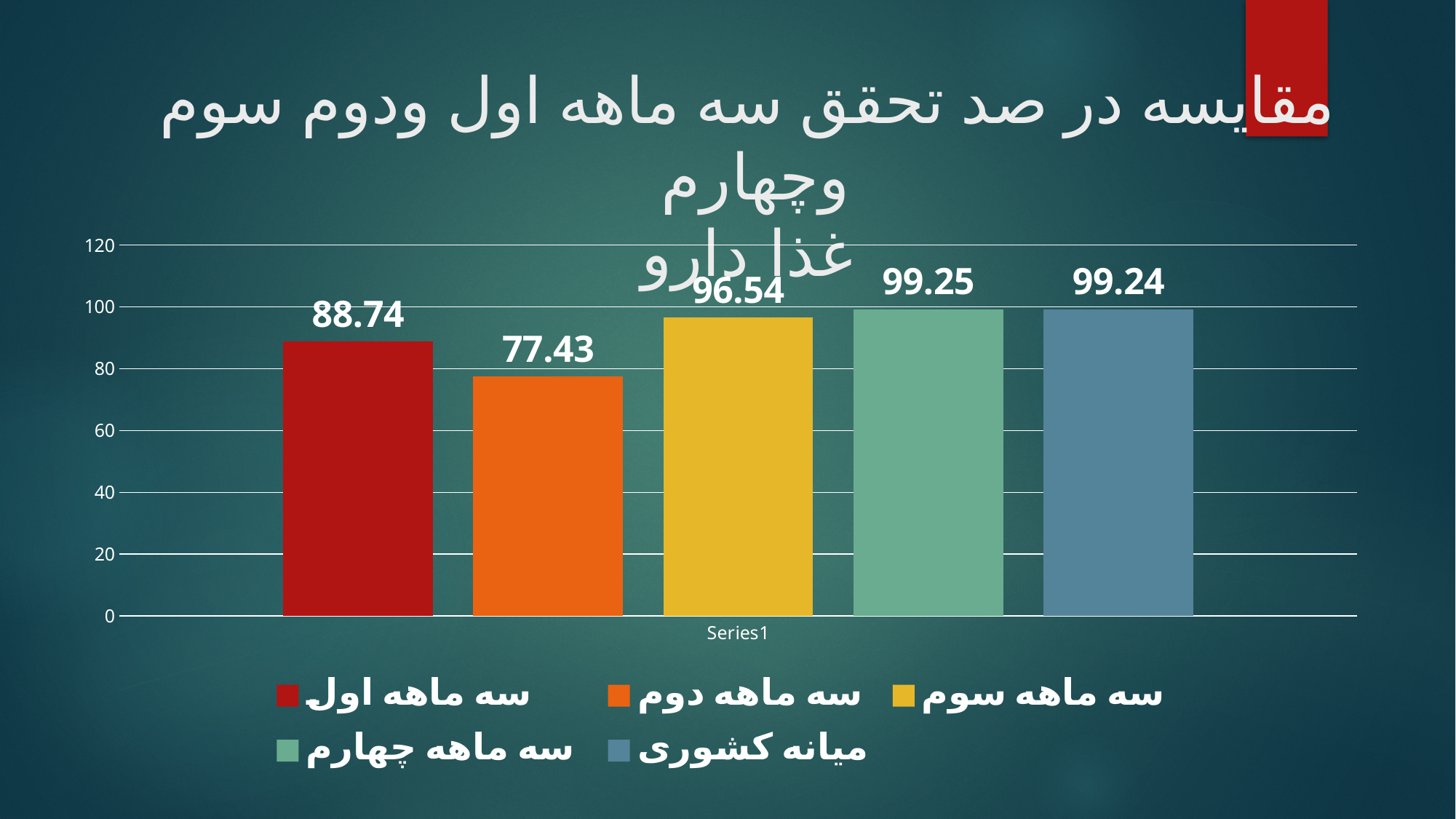
How many series does the legend list? 5 What kind of chart is shown on the slide? bar chart Which series has the lowest value? سه ماهه دوم What is the value for سه ماهه سوم? 96.54 Is the value for سه ماهه دوم greater or less than 80? less Which is larger, the value for سه ماهه سوم or the value for سه ماهه اول? سه ماهه سوم What is the difference between the values for سه ماهه اول and سه ماهه دوم? 11.31 What is the value for میانه کشوری? 99.24 What is the value for سه ماهه دوم? 77.43 What is the value for سه ماهه اول? 88.74 What is the difference between the values for سه ماهه چهارم and میانه کشوری? 0.01 What is the value for سه ماهه چهارم? 99.25